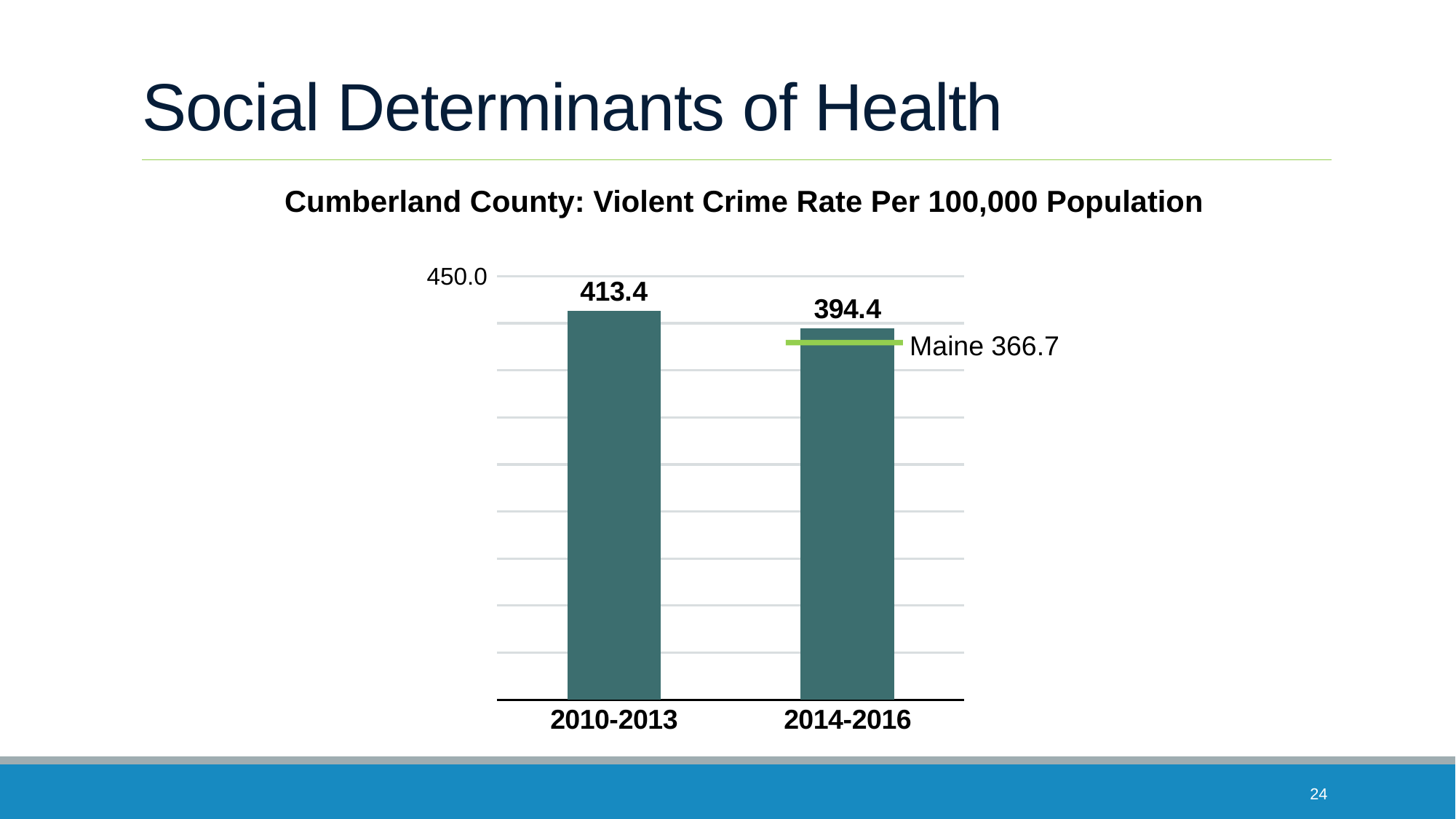
Is the Cumberland County 2014-2016 violent crime rate higher or lower than the Maine rate? higher What type of chart is used to show the violent crime rate? bar chart Which period has the higher violent crime rate in Cumberland County? 2010-2013 Which period has the lower violent crime rate in Cumberland County? 2014-2016 How much higher is the Cumberland County 2014-2016 rate than the Maine rate of 366.7? 27.7 Does the violent crime rate rise or fall from 2010-2013 to 2014-2016? fall What is the Maine violent crime rate shown by the reference line? 366.7 Is the 2010-2013 violent crime rate greater or less than 450.0? less What is the violent crime rate per 100,000 population for Cumberland County in 2014-2016? 394.4 What is the violent crime rate per 100,000 population for Cumberland County in 2010-2013? 413.4 What is the difference between the 2010-2013 and 2014-2016 violent crime rates? 19.0 How many time periods are shown as bars in the chart? 2